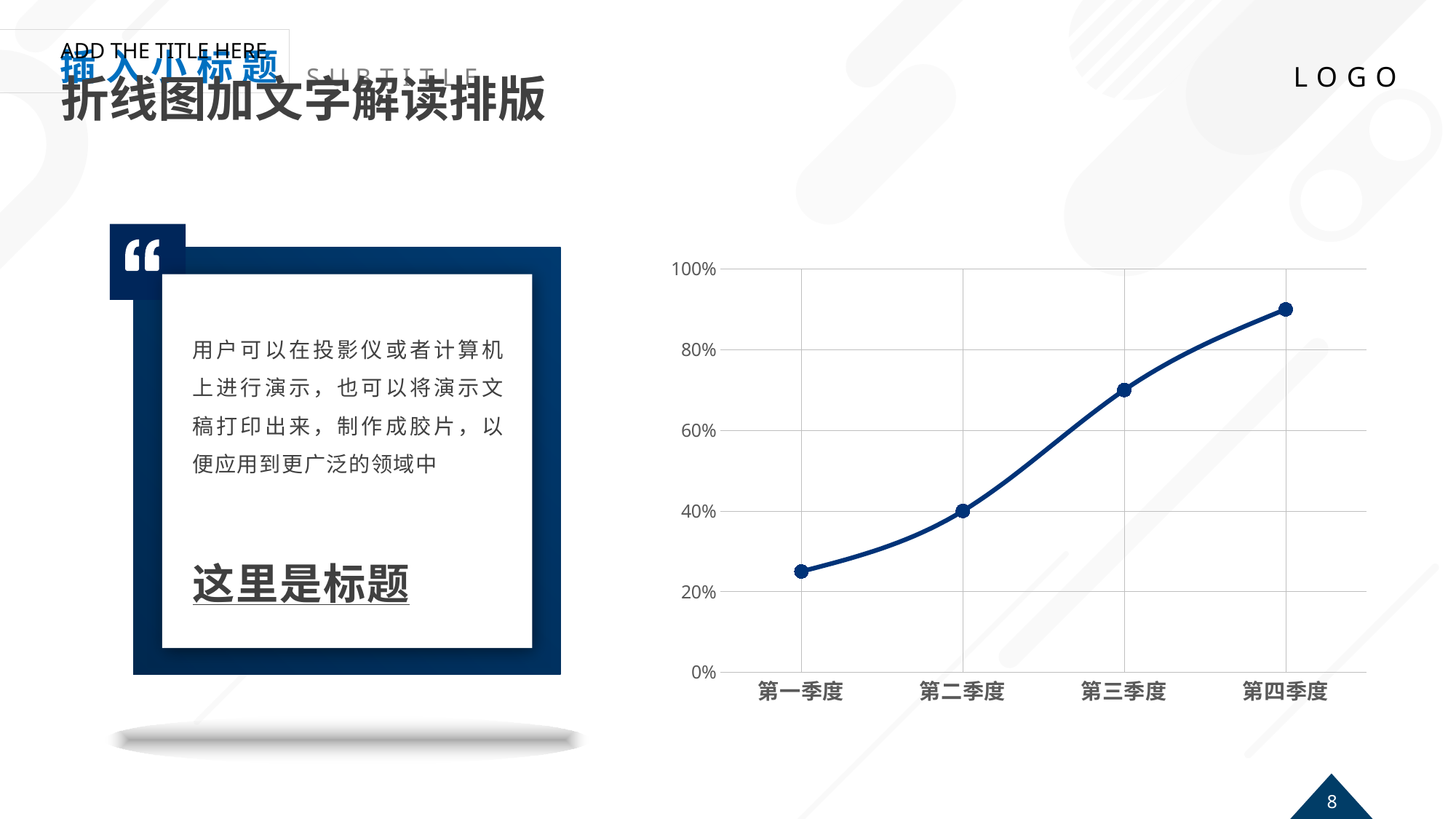
How many categories are plotted on the x axis of the line chart? 4 Is the value for 第三季度 greater or less than 80%? less What is the highest tick label shown on the y axis of the line chart? 100% Is the value for 第三季度 greater or less than 60%? greater Which category has the lowest value in the line chart? 第一季度 Which category has the highest value in the line chart? 第四季度 Do the values rise or fall from 第一季度 to 第四季度 in the line chart? rise Which is larger, the value for 第二季度 or the value for 第三季度? 第三季度 What is the value for 第二季度 in the line chart? 40% Is the value for 第四季度 greater or less than 80%? greater What kind of chart is shown on the slide? line chart